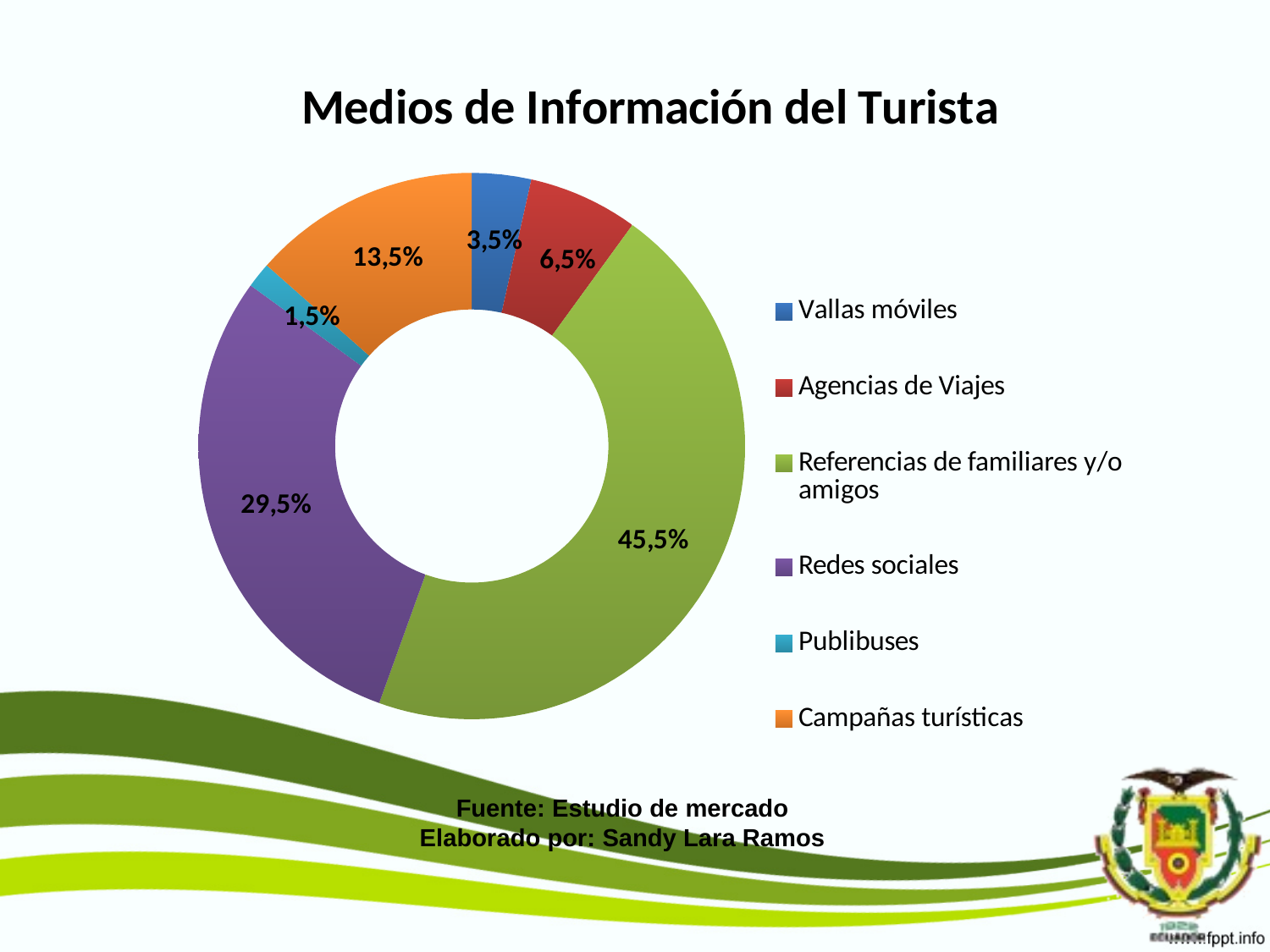
What is the difference between Referencias de familiares y/o amigos and Redes sociales? 16 percentage points Which category has the largest share? Referencias de familiares y/o amigos Which is larger, Agencias de Viajes or Vallas móviles? Agencias de Viajes What is the value for Publibuses? 1,5% What is the title of the chart? Medios de Información del Turista What kind of chart is shown on the slide? Doughnut (pie) chart What is the value for Redes sociales? 29,5% What is the value for Campañas turísticas? 13,5% What is the value for Vallas móviles? 3,5% What is the value for Referencias de familiares y/o amigos? 45,5% Which category has the smallest share? Publibuses How many categories does the chart show? 6